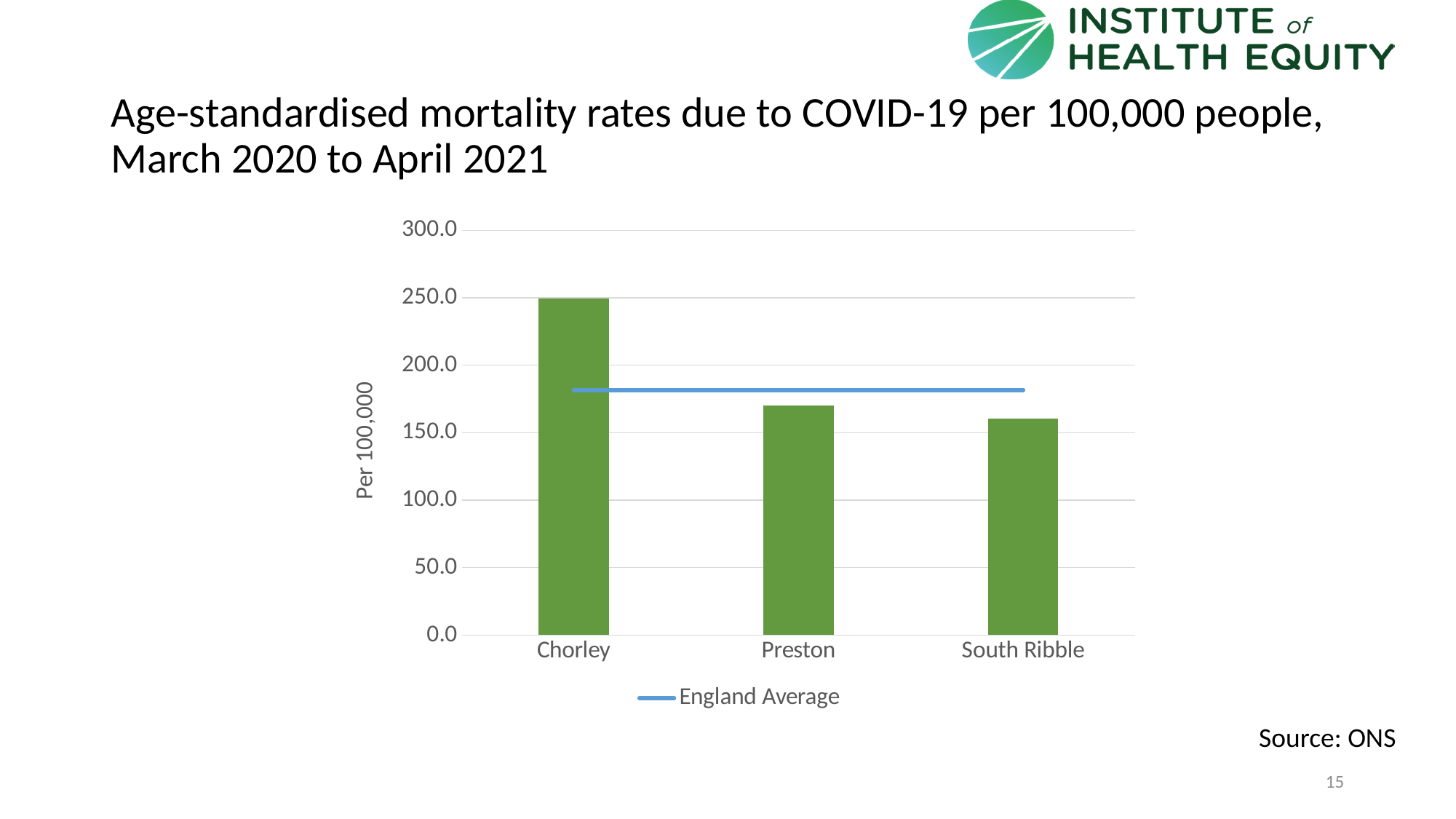
How many local areas are plotted as bars on the chart? 3 Do the bar values rise or fall from left to right across the x axis? fall Which area has the lowest age-standardised COVID-19 mortality rate? South Ribble Is the value for Preston greater or less than 200.0? less Which area has the highest age-standardised COVID-19 mortality rate? Chorley What kind of chart is shown on the slide? combination bar and line chart Which has the higher mortality rate, Chorley or Preston? Chorley What is the label on the vertical axis? Per 100,000 Is the value for South Ribble greater or less than 150.0? greater Is Chorley's mortality rate above or below the England Average line? above Is the England Average line greater or less than 200.0? less